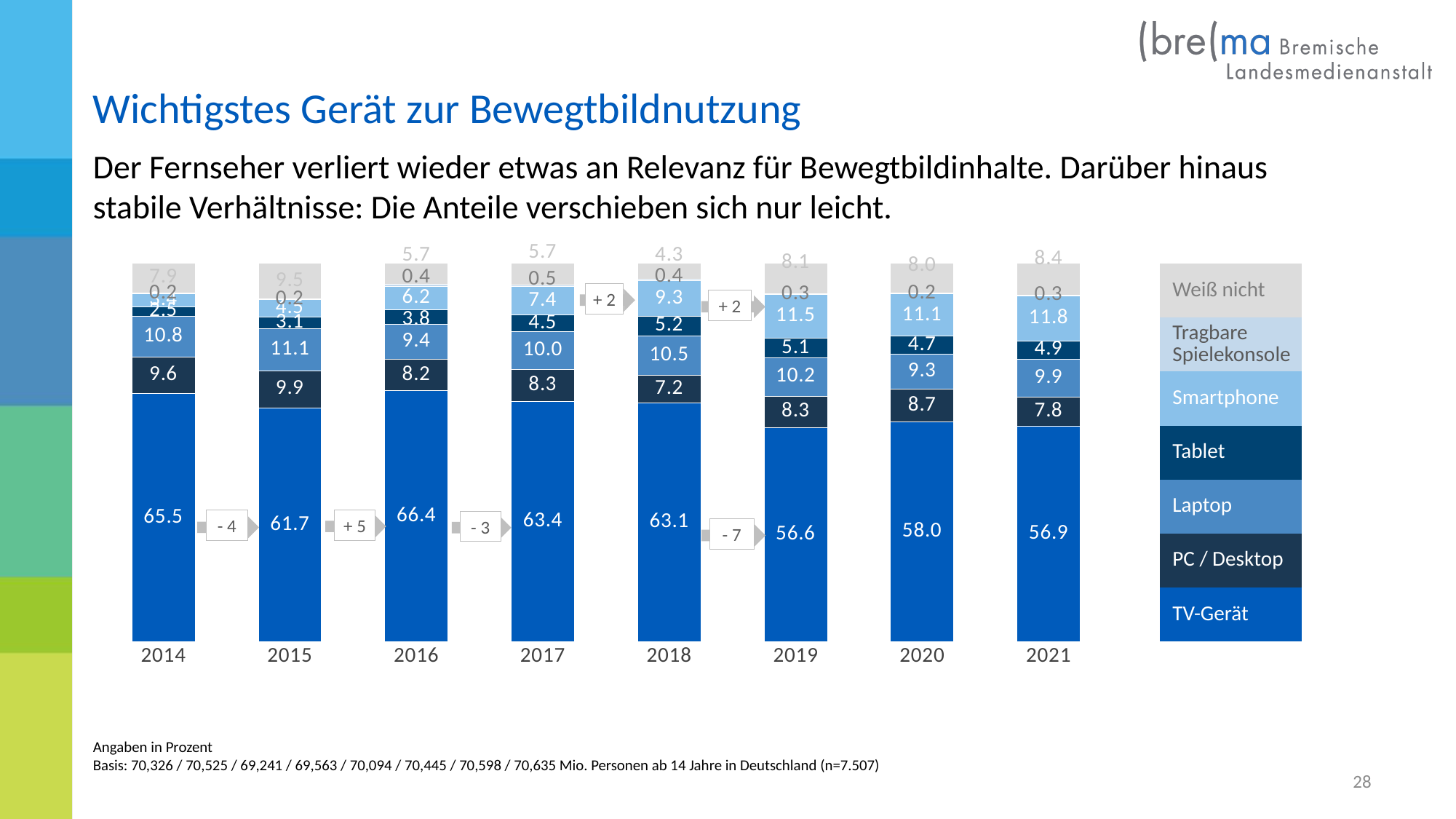
What is the value for PC / Desktop in 2020? 8.7 What is the difference between the TV-Gerät values for 2014 and 2021? 8.6 What type of chart is shown on the slide? Stacked bar chart What is the value for TV-Gerät in 2016? 66.4 What is the value for Smartphone in 2021? 11.8 In which year is the TV-Gerät value lowest? 2019 How many years are shown on the x axis? 8 Does the Smartphone value rise or fall from 2014 to 2019? Rise Which is larger in 2019: the Smartphone value or the Laptop value? Smartphone How many series does the legend list? 7 What is the value for Laptop in 2018? 10.5 In which year is the TV-Gerät value highest? 2016